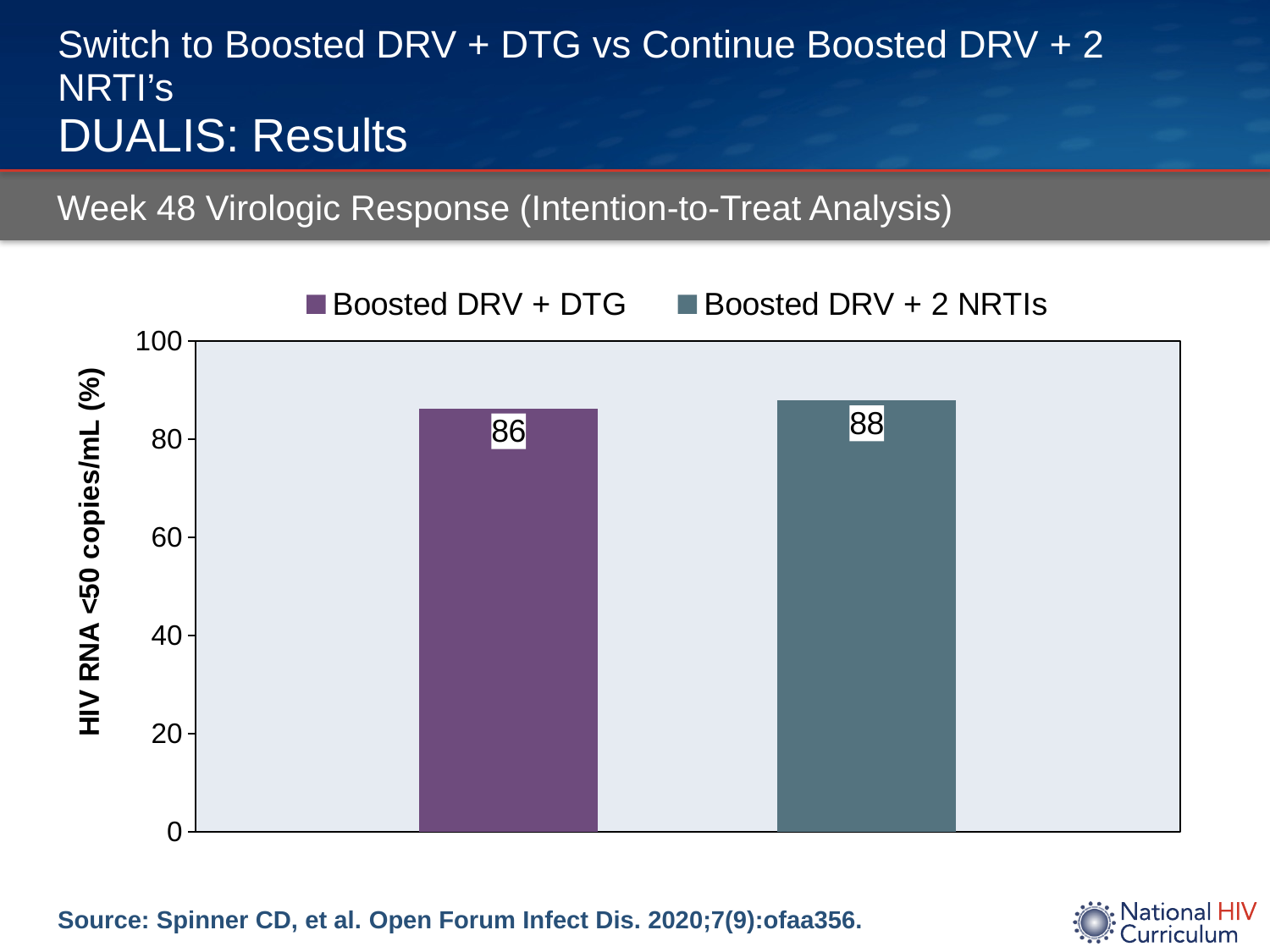
What is the value for Boosted DRV + DTG? 86 What is the difference between the values for Boosted DRV + 2 NRTIs and Boosted DRV + DTG? 2 How many bars are plotted on the chart? 2 Is the value for Boosted DRV + 2 NRTIs greater or less than 100? less What is the maximum value shown on the y axis? 100 Which series has the higher value, Boosted DRV + DTG or Boosted DRV + 2 NRTIs? Boosted DRV + 2 NRTIs Which series has the lower value? Boosted DRV + DTG What is the value for Boosted DRV + 2 NRTIs? 88 What is the label of the y axis? HIV RNA <50 copies/mL (%) Is the value for Boosted DRV + DTG greater or less than 80? greater How many series does the legend list? 2 What kind of chart is shown on the slide? Bar chart